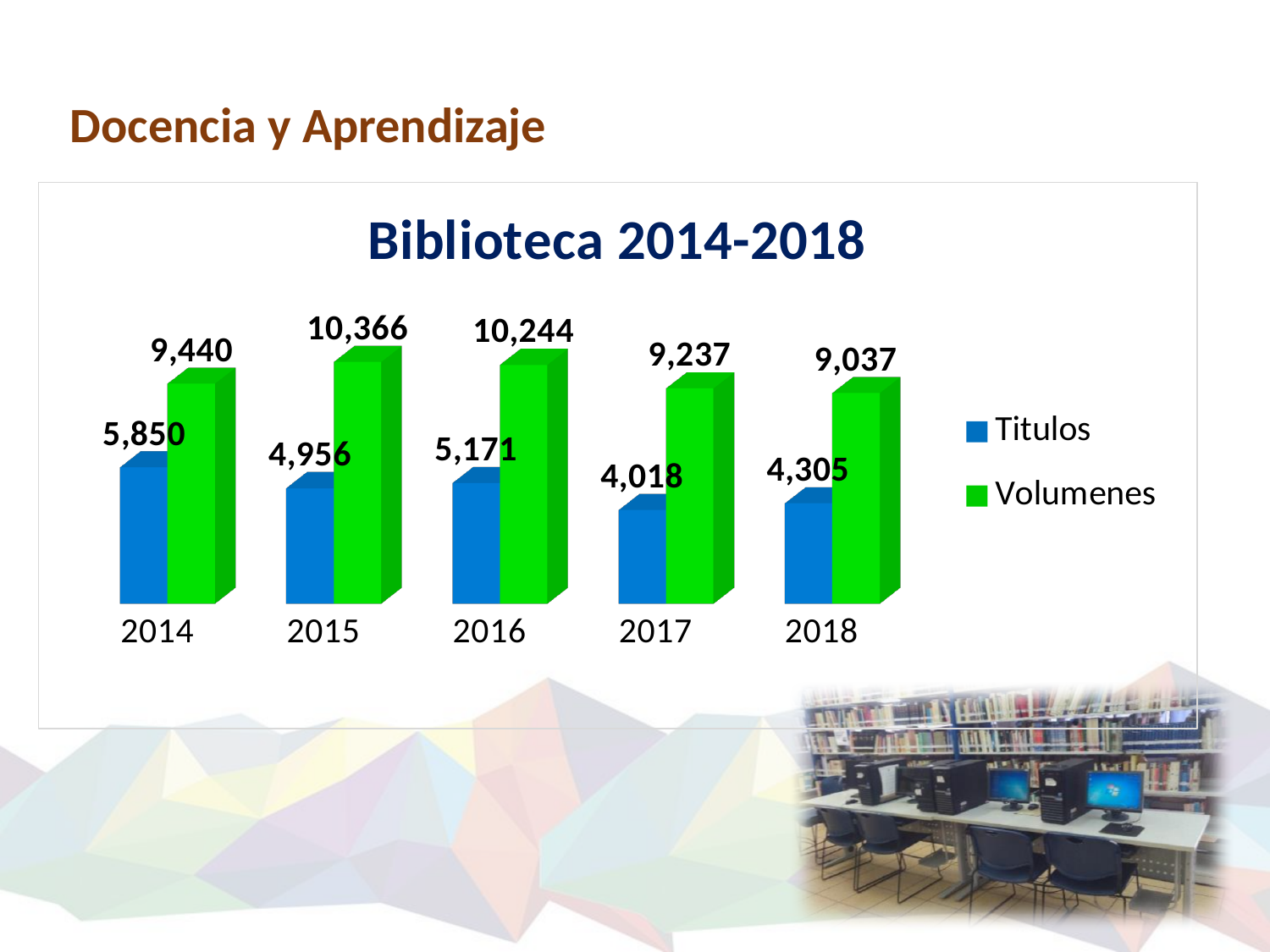
What is the value for Titulos in 2014? 5,850 What is the title of the chart? Biblioteca 2014-2018 How many series does the legend list? 2 Which is larger, Titulos in 2015 or Titulos in 2016? Titulos in 2016 What is the value for Volumenes in 2016? 10,244 Do the Volumenes values rise or fall from 2016 to 2018? Fall What is the value for Titulos in 2018? 4,305 Which year has the lowest value for Titulos? 2017 How many years are shown on the x axis? 5 Which year has the highest value for Volumenes? 2015 What kind of chart is shown? Bar chart What is the difference between Volumenes and Titulos in 2017? 5,219